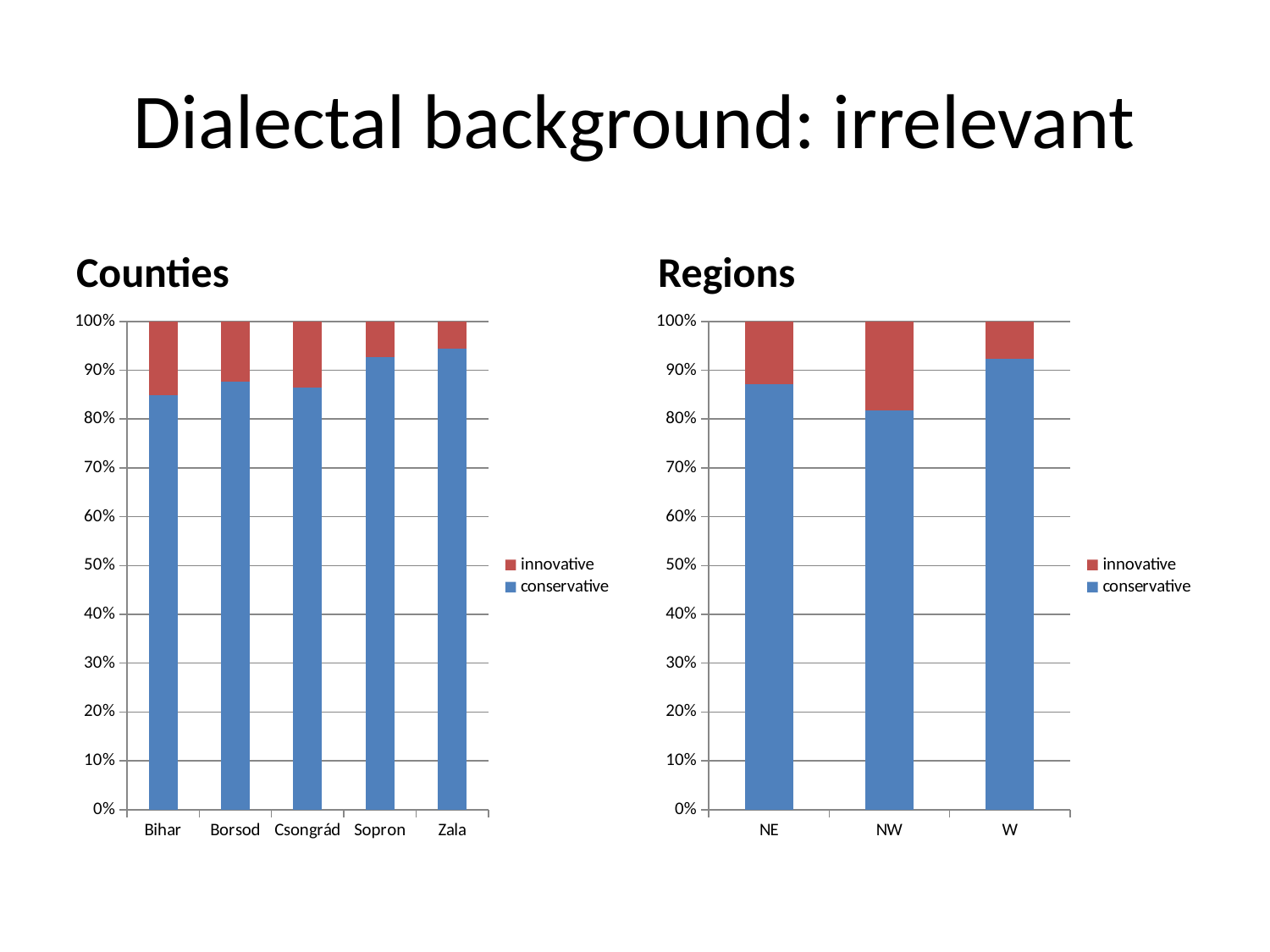
Which colour represents the innovative series on the Counties chart? red How many regions are shown on the Regions chart? 3 On the Counties chart, is the conservative share for Sopron greater or less than 90%? greater How many series does the legend of the Regions chart list? 2 On the Regions chart, which region has the lowest conservative share? NW On the Regions chart, which has the larger innovative share, NW or W? NW On the Counties chart, is the conservative share for Bihar greater or less than 90%? less On the Regions chart, which region has the highest conservative share? W What kind of chart is the Counties chart? stacked bar chart On the Counties chart, which has the larger conservative share, Sopron or Bihar? Sopron On the Regions chart, is the conservative share for NW greater or less than 90%? less How many counties are shown on the Counties chart? 5